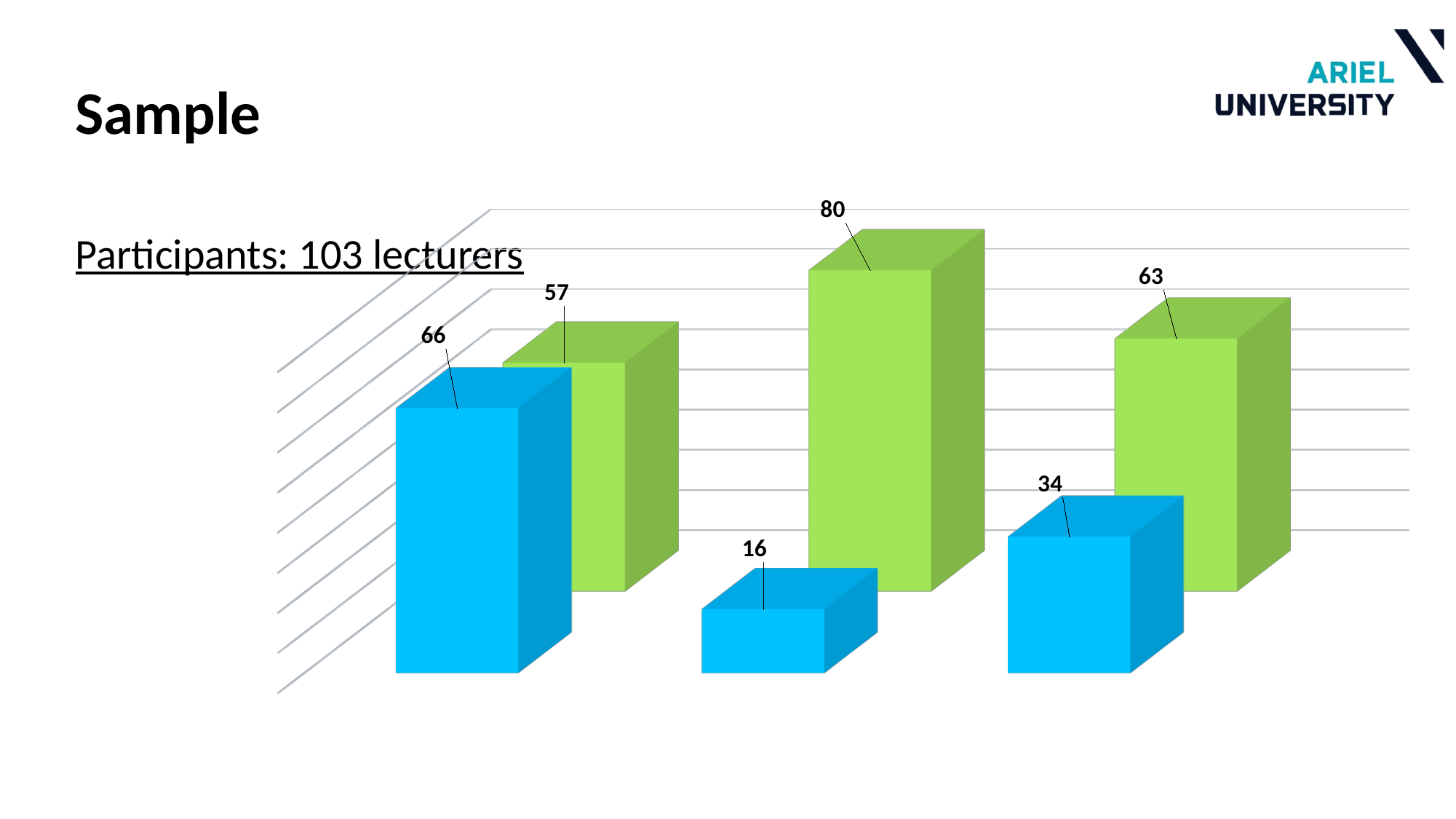
What is the value of the blue bar in the first (leftmost) group? 66 What is the value of the blue bar in the middle group? 16 What is the lowest value shown on the chart? 16 What is the highest value shown on the chart? 80 How many groups of bars does the chart show? 3 What is the value of the blue bar in the third (rightmost) group? 34 What is the value of the green bar in the middle group? 80 What kind of chart is shown on the slide? bar chart What is the value of the green bar in the first (leftmost) group? 57 In the middle group, what is the difference between the green bar and the blue bar? 64 In the first (leftmost) group, which bar is larger, the blue one or the green one? blue How many bars are plotted in total on the chart? 6